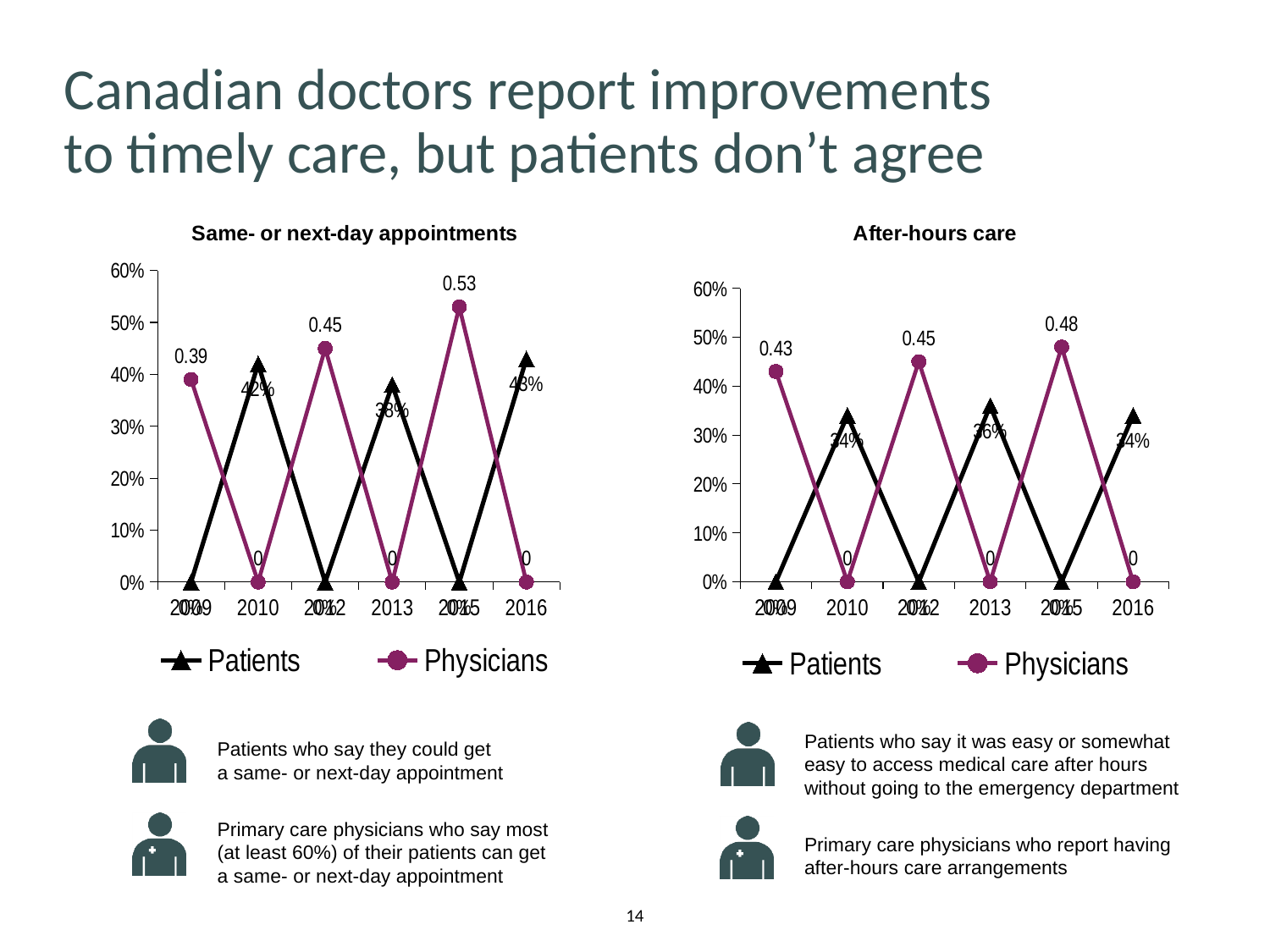
In the 'Same- or next-day appointments' chart, what is the highest labelled value for Physicians? 0.53 Which series is drawn with triangle markers in the 'Same- or next-day appointments' chart? Patients In the 'Same- or next-day appointments' chart, what is the lowest labelled non-zero value for Physicians? 0.39 In the 'After-hours care' chart, what is the highest labelled value for Physicians? 0.48 In the 'Same- or next-day appointments' chart, what is the difference between the Patients values for 2016 and 2013? 5% In the 'Same- or next-day appointments' chart, what is the value for Patients in 2016? 43% In the 'After-hours care' chart, what is the value for Patients in 2010? 34% What kind of chart is the 'Same- or next-day appointments' chart? line chart In the 'After-hours care' chart, is the Patients value for 2013 greater or less than 30%? greater In the 'Same- or next-day appointments' chart, what is the value for Patients in 2013? 38% In the 'After-hours care' chart, what is the value for Patients in 2013? 36% How many series does the legend of the 'After-hours care' chart list? 2